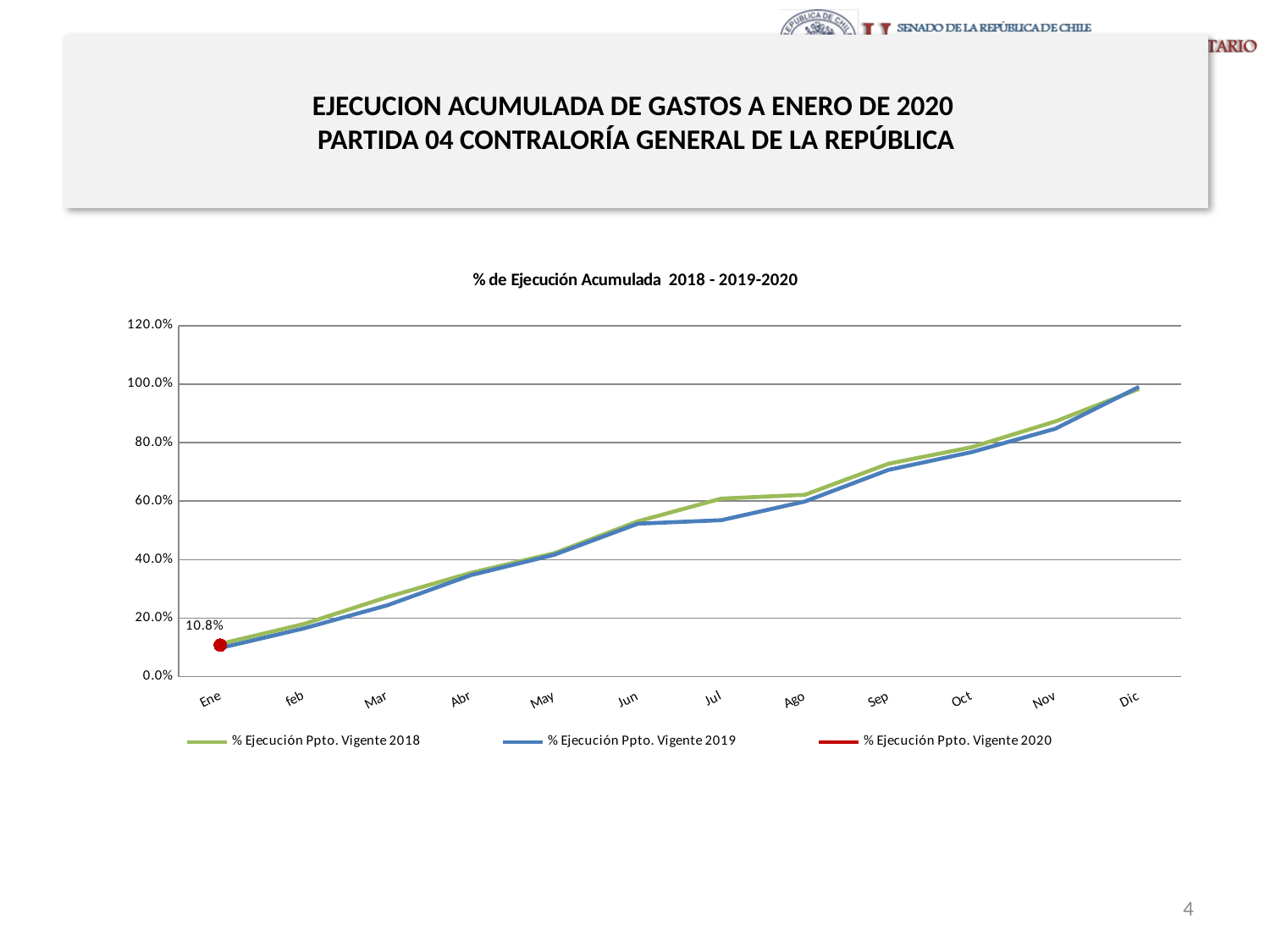
What is the value shown for % Ejecución Ppto. Vigente 2020 in Ene? 10.8% What kind of chart is shown on the slide? Line chart In Jul, which series has the higher value: % Ejecución Ppto. Vigente 2018 or % Ejecución Ppto. Vigente 2019? % Ejecución Ppto. Vigente 2018 How many months are shown on the x axis of the chart? 12 In which month does % Ejecución Ppto. Vigente 2019 have its lowest value? Ene Is the value for % Ejecución Ppto. Vigente 2019 in Mar greater or less than 40.0%? less Is the value for % Ejecución Ppto. Vigente 2019 in Jul greater or less than 60.0%? less What is the title of the chart? % de Ejecución Acumulada 2018 - 2019-2020 Is the value for % Ejecución Ppto. Vigente 2018 in Dic greater or less than 80.0%? greater In which month does % Ejecución Ppto. Vigente 2018 reach its highest value? Dic How many series does the chart legend list? 3 Do the values for % Ejecución Ppto. Vigente 2018 rise or fall from Ene to Dic? Rise